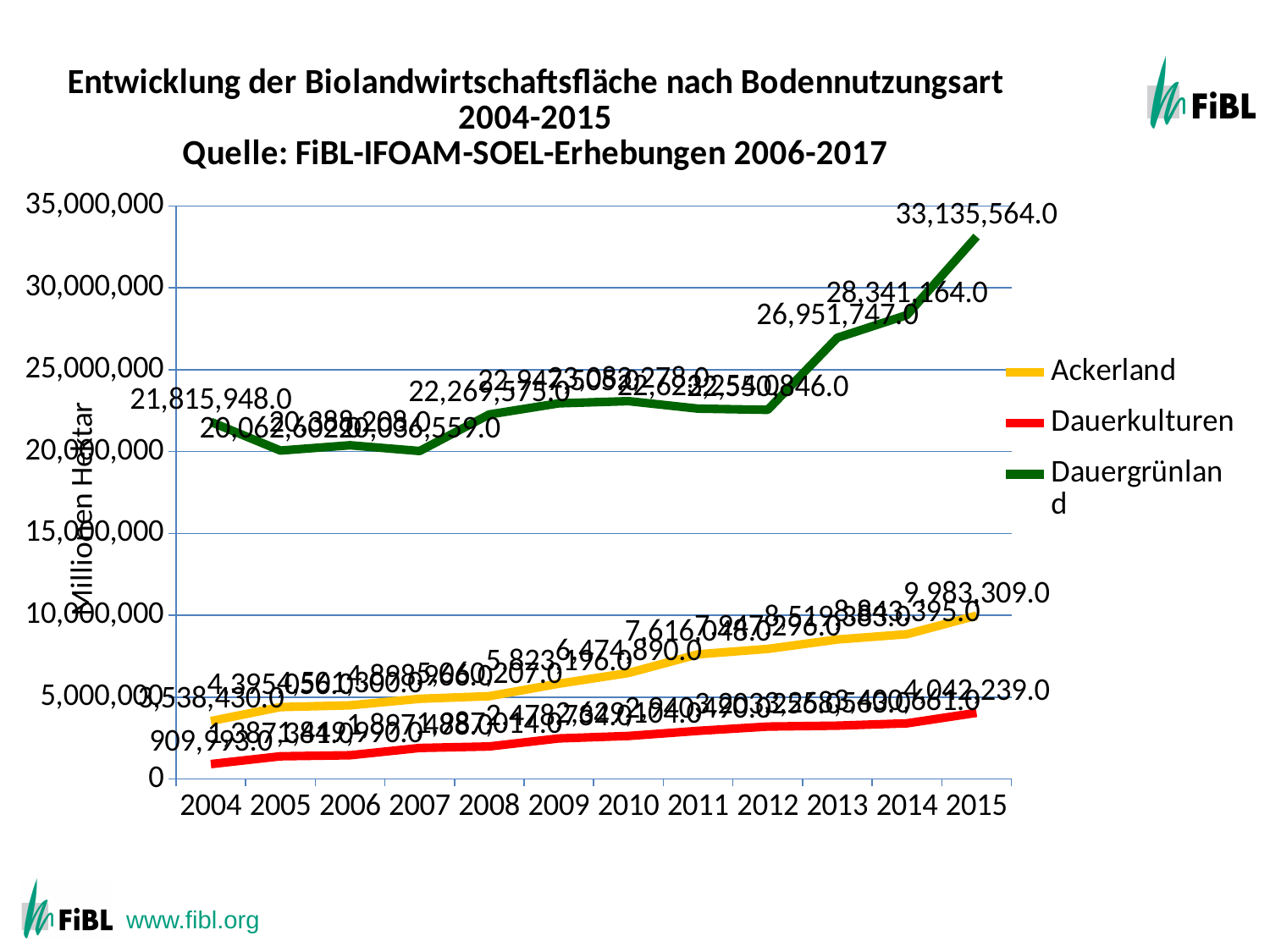
What is the value for Dauergrünland in 2013? 26,951,747.0 How many series does the legend list? 3 What is the value for Dauerkulturen in 2015? 4,042,239.0 By how much did Dauergrünland increase from 2014 to 2015? 4,794,400.0 What is the value for Dauergrünland in 2014? 28,341,164.0 How many years are shown on the x axis? 12 What is the value for Dauergrünland in 2015? 33,135,564.0 Which series has the highest value in 2015? Dauergrünland Does the Dauergrünland line rise or fall from 2012 to 2015? rise Is the value for Dauerkulturen in 2010 greater or less than 5,000,000? less What kind of chart is shown on the slide? line chart What is the value for Ackerland in 2015? 9,983,309.0